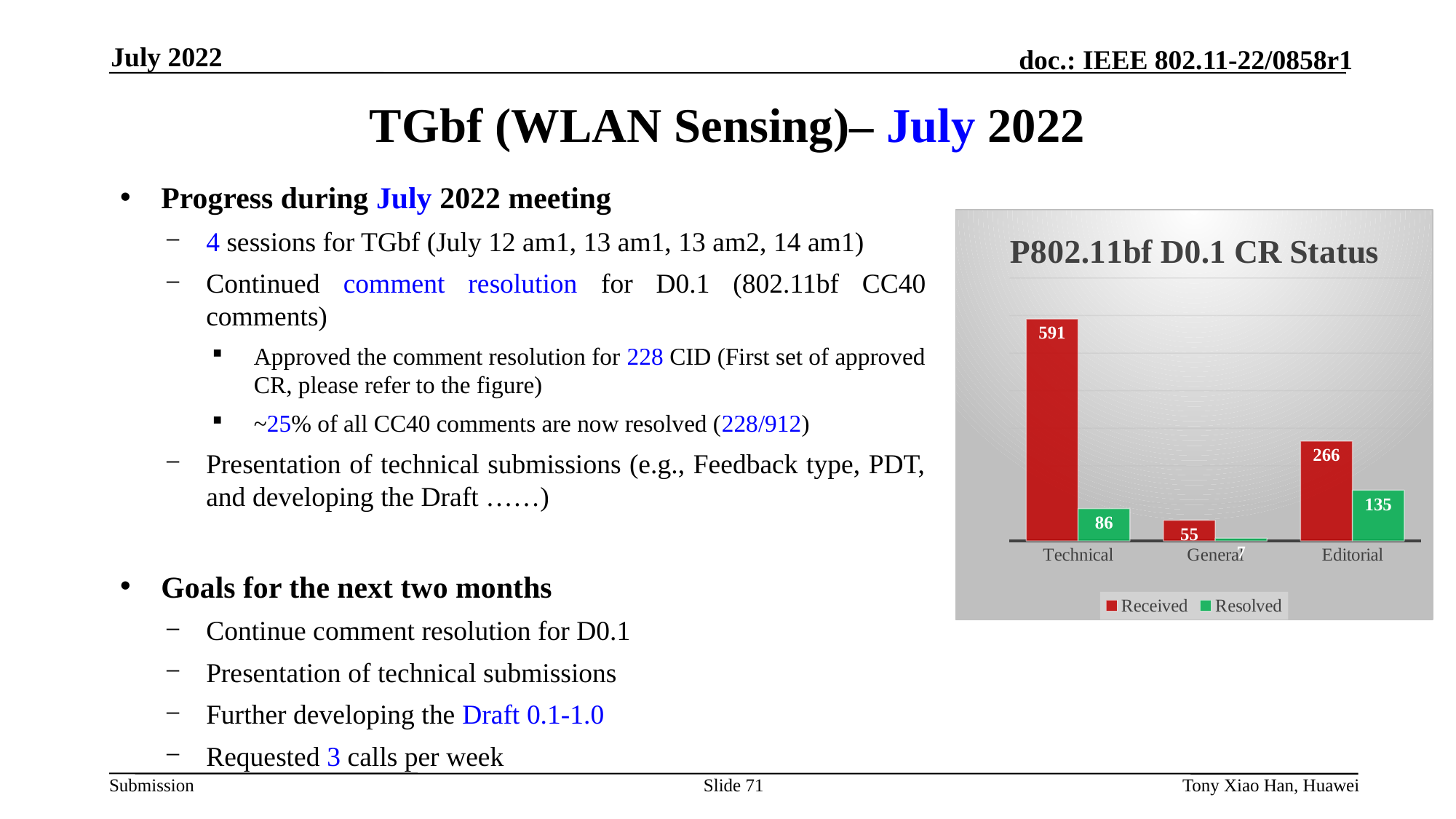
Which category has the lowest Received value? General What is the difference between the Received values for Technical and Editorial? 325 What is the Resolved value for Editorial in the chart? 135 Which is larger, the Resolved value for Technical or for Editorial? Editorial How many series does the legend list in the chart? 2 What is the Received value for General? 55 What is the Received value for Technical in the P802.11bf D0.1 CR Status chart? 591 What is the Resolved value for Technical? 86 Which category has the highest Resolved value? Editorial What is the Received value for Editorial? 266 Which category has the highest Received value? Technical What is the difference between Received and Resolved for Technical? 505